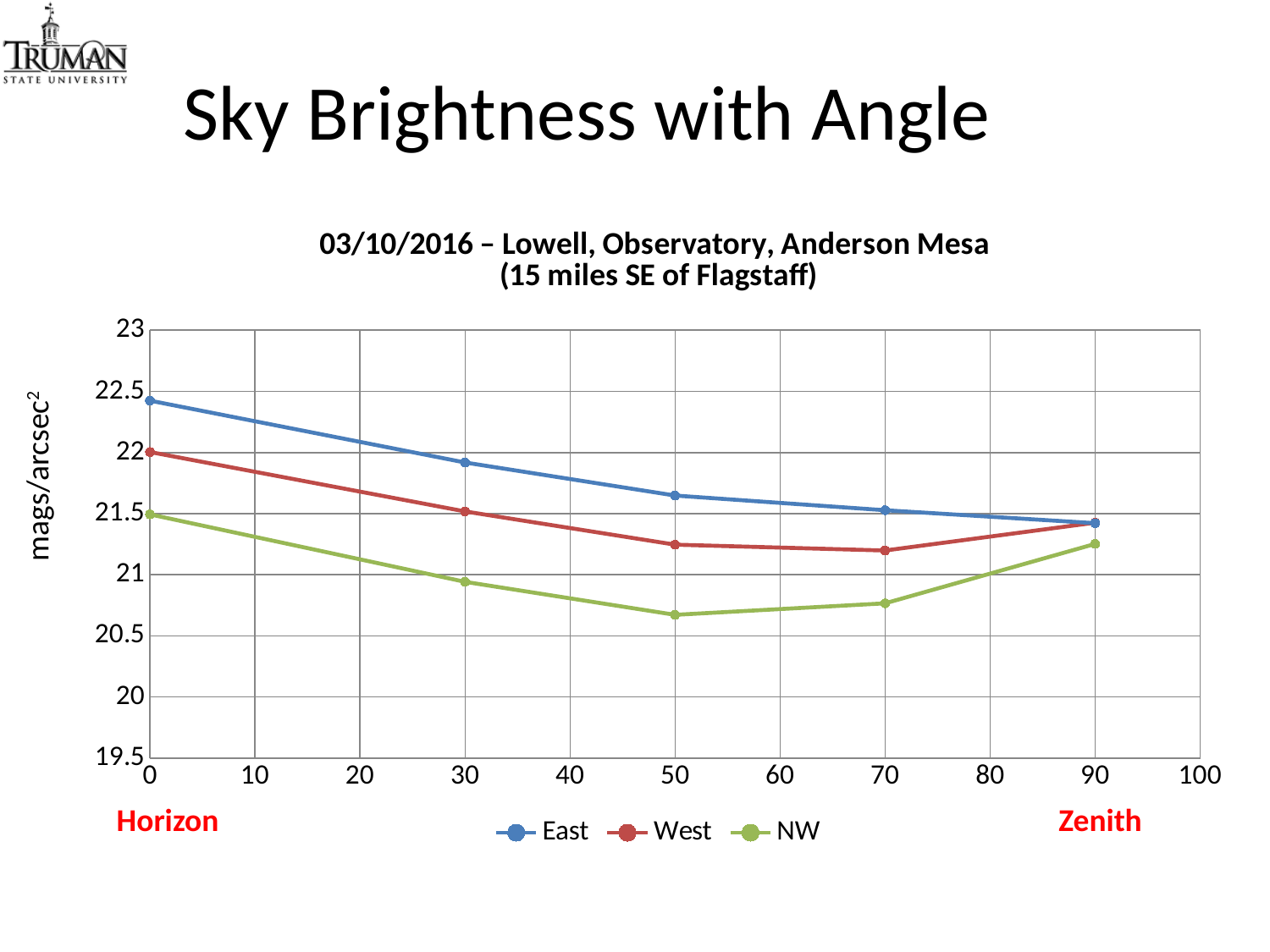
Does the NW series rise or fall from angle 50 to angle 90? rise Is the value for East at angle 0 greater or less than 22? greater What is the label on the vertical axis of the chart? mags/arcsec² Which series has the highest value at angle 0? East What kind of chart is shown on the slide? line chart Which series has the lowest value at angle 50? NW How many series does the legend list? 3 Is the value for NW at angle 50 greater or less than 21? less Is the value for West at angle 70 greater or less than 21.5? less Does the East series rise or fall from angle 0 to angle 90? fall At angle 30, which is larger, the East value or the NW value? East How many data points are plotted for the East series? 5